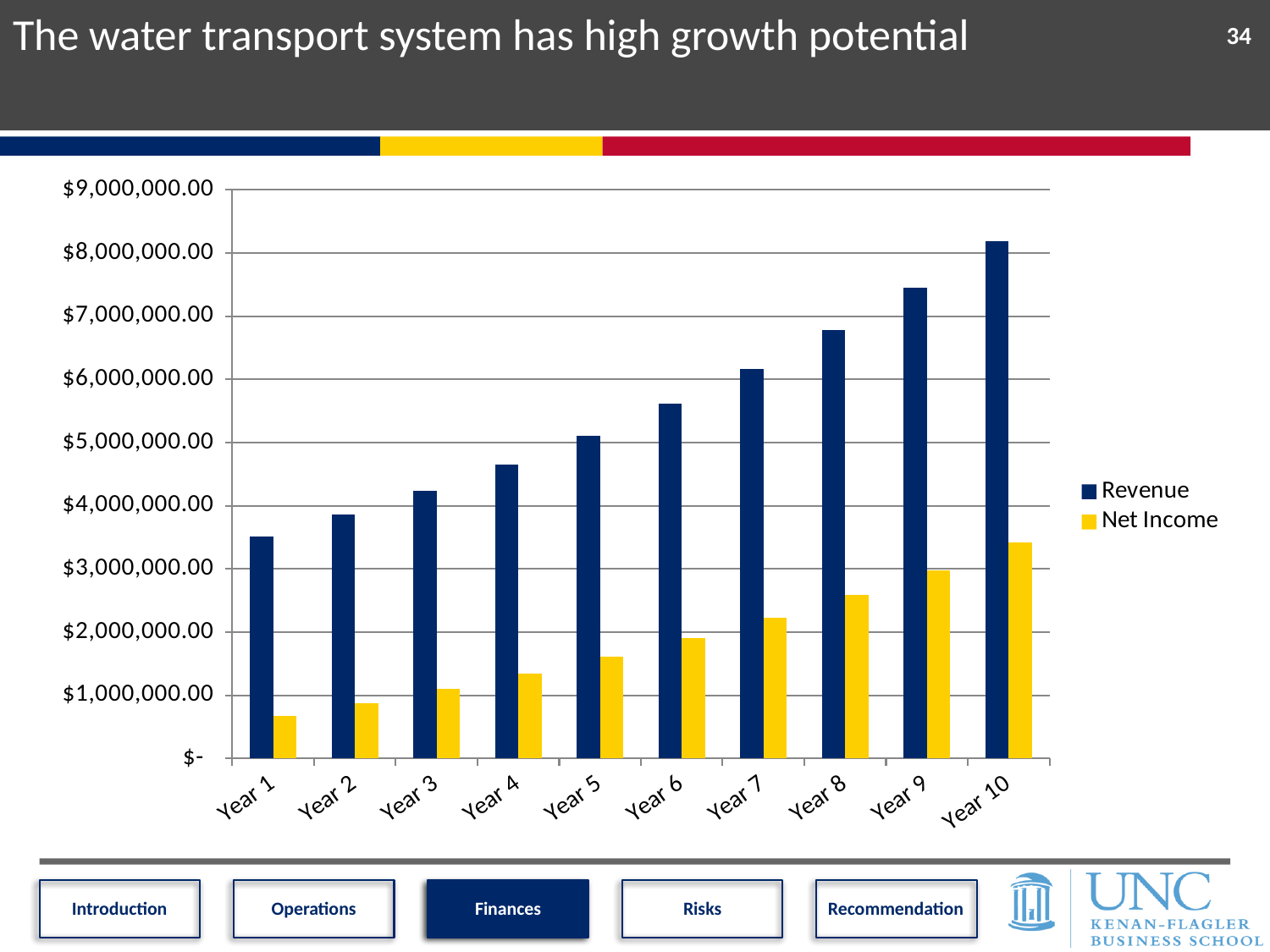
What kind of chart is shown on the slide? Bar chart Is the Revenue for Year 1 greater or less than $4,000,000.00? less How many years are shown on the x axis? 10 Which year has the highest Revenue? Year 10 What colour are the Net Income bars? Yellow Which year has the lowest Net Income? Year 1 How many series does the legend list? 2 Is the Net Income for Year 10 greater or less than $3,000,000.00? greater Is the Revenue for Year 10 greater or less than $8,000,000.00? greater Which is larger, the Revenue for Year 3 or the Net Income for Year 10? Revenue for Year 3 Do Revenue values rise or fall from Year 1 to Year 10? Rise